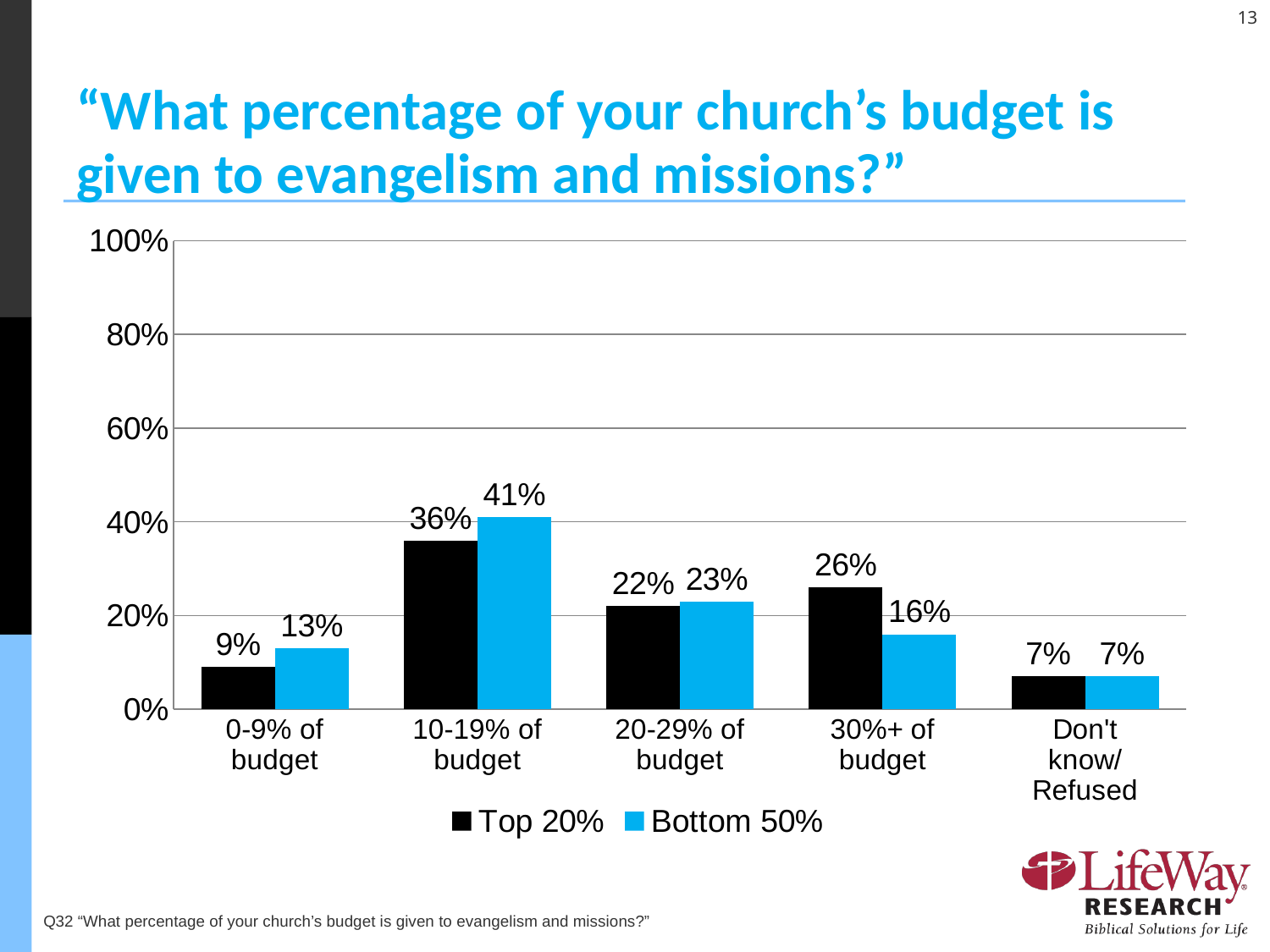
In the 0-9% of budget category, which series has the larger value, Top 20% or Bottom 50%? Bottom 50% What is the value for Top 20% in the 10-19% of budget category? 36% Which category has the lowest value for the Top 20% series? Don't know/ Refused Is the value for Bottom 50% in the 10-19% of budget category greater or less than 40%? greater What colour represents the Bottom 50% series? blue Which category has the highest value for the Bottom 50% series? 10-19% of budget What is the value for Bottom 50% in the 30%+ of budget category? 16% What is the difference between the Top 20% and Bottom 50% values in the 30%+ of budget category? 10% What kind of chart is shown on the slide? bar chart What is the value for Bottom 50% in the 0-9% of budget category? 13% How many categories are shown on the x axis? 5 How many series does the legend list? 2